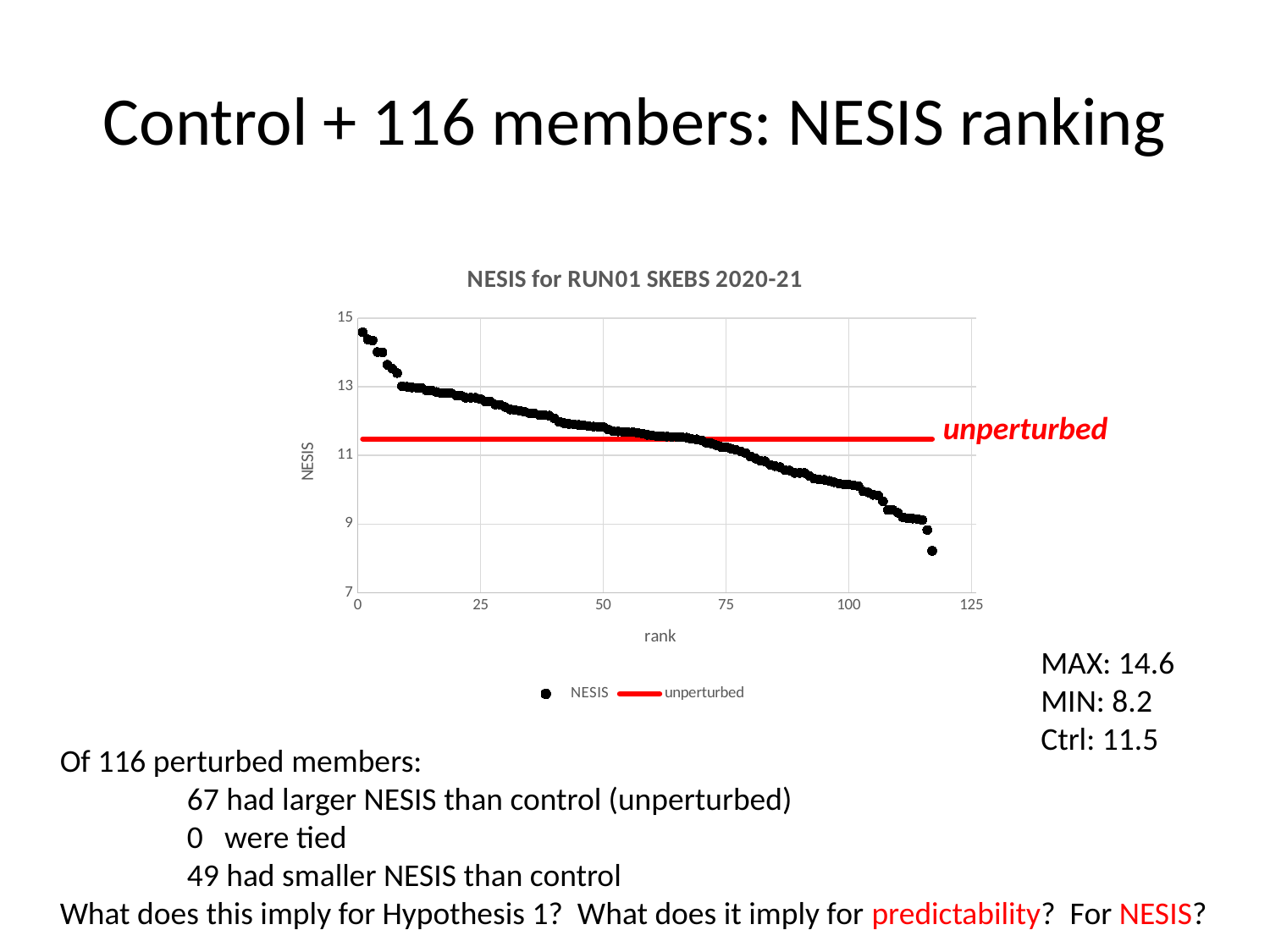
What is the title of the chart? NESIS for RUN01 SKEBS 2020-21 What is the label of the x axis of the chart? rank What is the minimum NESIS value among the members? 8.2 How many perturbed members are plotted in the NESIS ranking? 116 Which has the larger NESIS value, the member at rank 10 or the member at rank 100? rank 10 Do the NESIS values rise or fall as rank increases along the x axis? fall What is the maximum NESIS value among the members? 14.6 Is the NESIS value at rank 1 greater or less than 13? greater What is the NESIS value of the unperturbed (control) run shown by the red line? 11.5 What kind of chart is shown on the slide? scatter chart What is the difference between the maximum NESIS value and the control NESIS value? 3.1 How many series does the chart legend list? 2